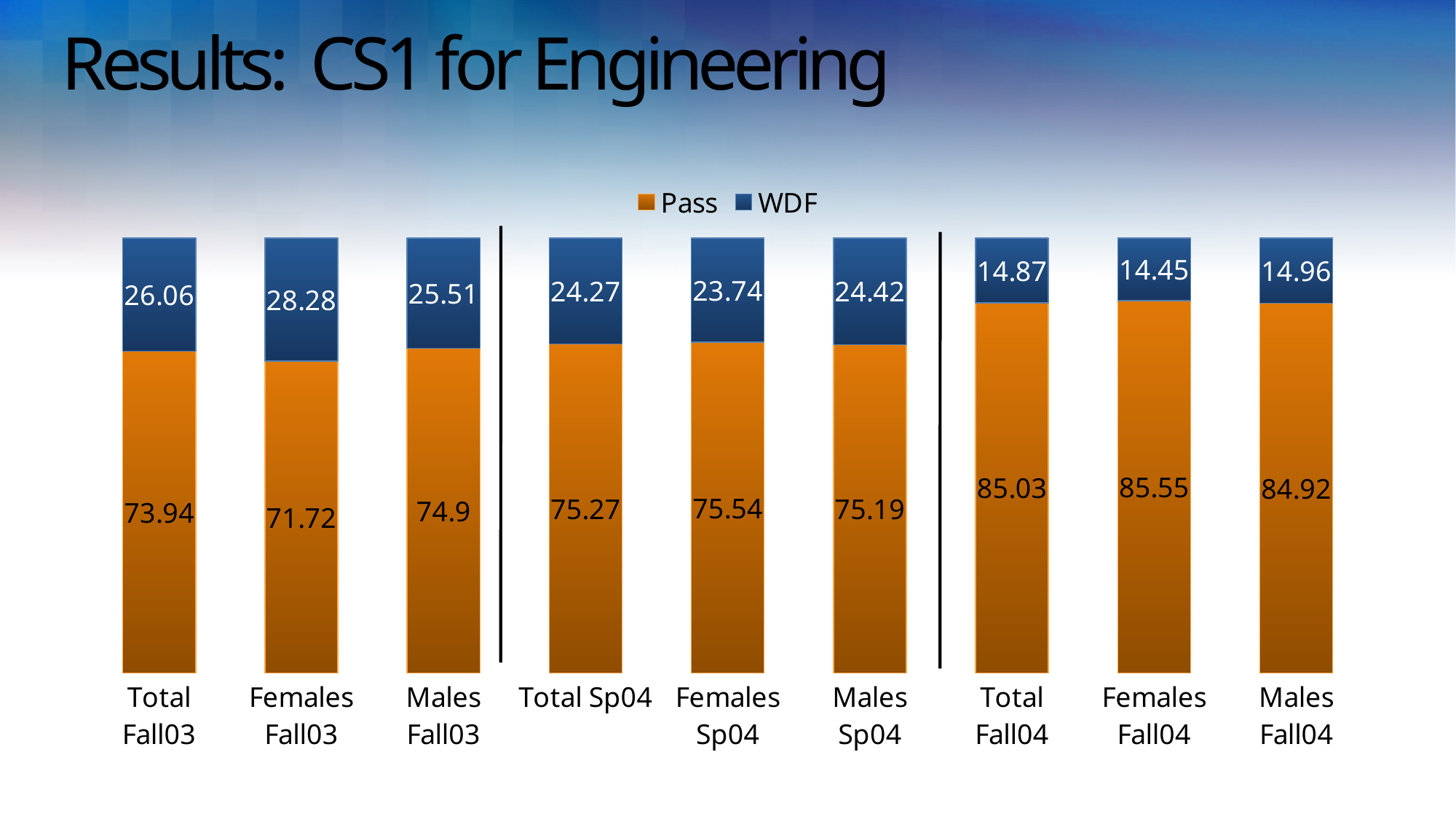
What is the difference between the Pass value for Total Fall04 and the Pass value for Total Fall03? 11.09 What is the WDF value for Males Fall04? 14.96 Which category has the lowest Pass value? Females Fall03 What is the total of the stacked bar for Total Fall03? 100 Which has the larger Pass value, Females Sp04 or Males Sp04? Females Sp04 What is the Pass value for Females Fall03? 71.72 How many series does the legend list? 2 Which category has the highest Pass value? Females Fall04 Which category has the lowest WDF value? Females Fall04 Which category has the highest WDF value? Females Fall03 How many categories are shown on the x axis? 9 What kind of chart is shown on the slide? Stacked bar chart